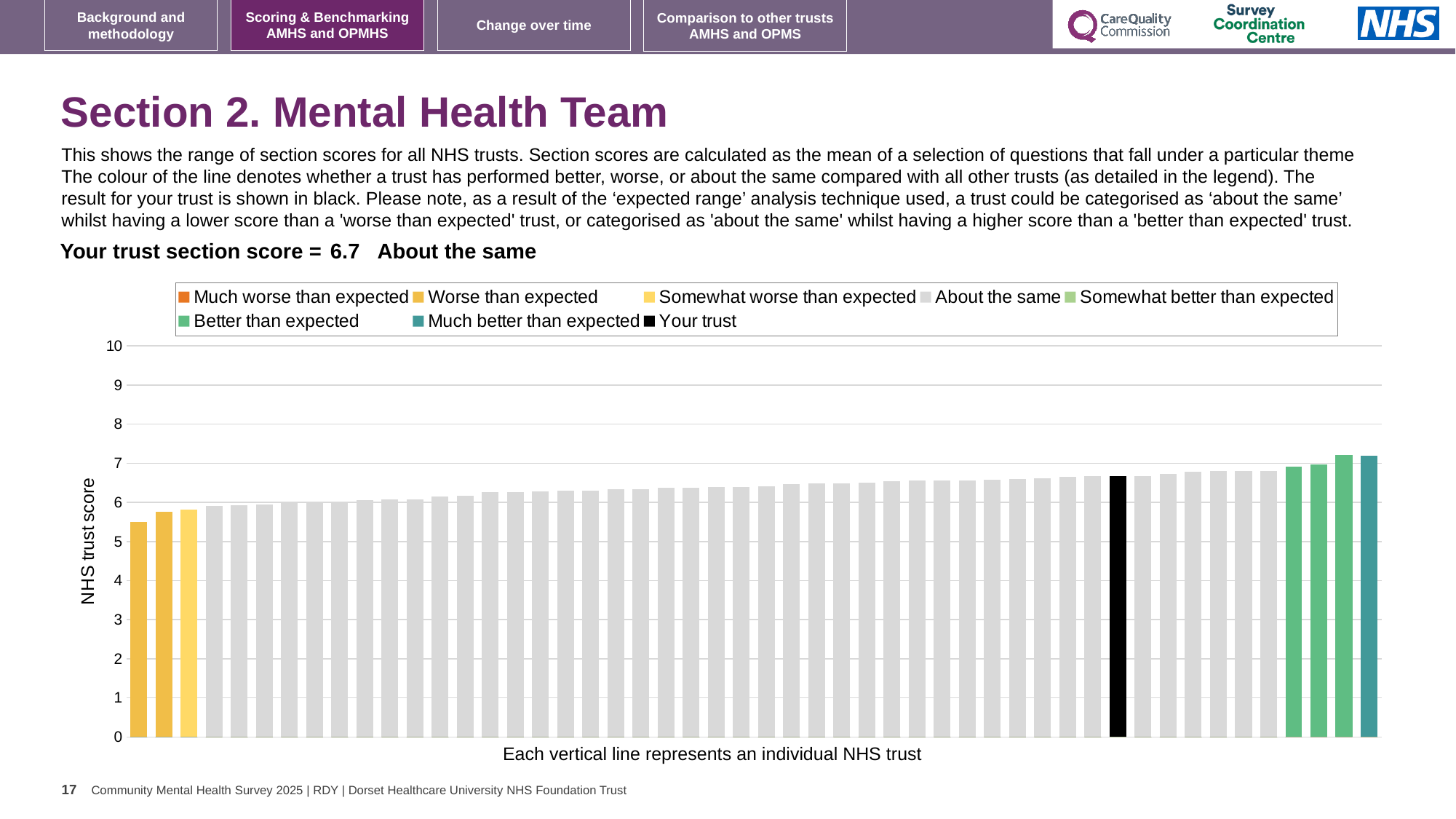
Do the bar values rise or fall from left to right along the x axis? rise How many bars are coloured yellow (worse than expected)? 2 What kind of chart is shown on the slide? bar chart Is the value of the black bar (your trust) greater or less than 6? greater Is the value of the leftmost (lowest) bar greater or less than 5? greater Is the value of the black bar (your trust) greater or less than 7? less How many entries does the chart legend list? 8 What is the label of the y axis? NHS trust score Which category is your trust placed in, according to the text above the chart? About the same What is the section score for your trust, as printed on the slide? 6.7 What is the highest value shown on the y axis? 10